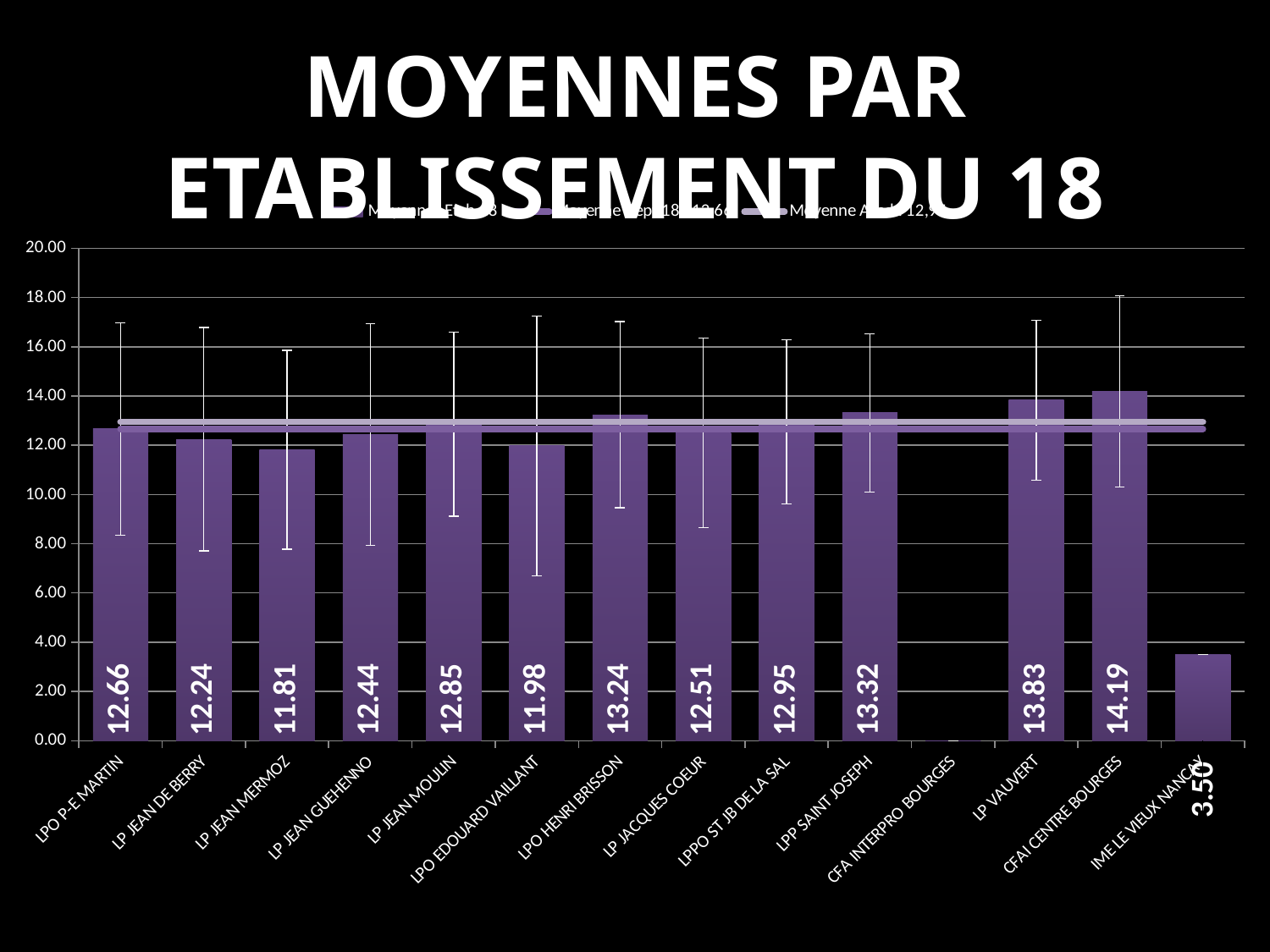
What is the difference between the values for CFAI CENTRE BOURGES and IME LE VIEUX NANCAY? 10.69 Is the value for IME LE VIEUX NANCAY greater or less than 4.00? less Which establishment has the highest value? CFAI CENTRE BOURGES What is the value for LPP SAINT JOSEPH? 13.32 What kind of chart is shown on the slide? bar chart What is the difference between the values for LP VAUVERT and LPO P-E MARTIN? 1.17 Which establishment has the lowest value shown? IME LE VIEUX NANCAY What is the value for LPO P-E MARTIN? 12.66 How many establishments are listed on the x axis? 14 Which is larger, the value for LPO HENRI BRISSON or the value for LP JACQUES COEUR? LPO HENRI BRISSON What is the value for LP JEAN MERMOZ? 11.81 What is the value for IME LE VIEUX NANCAY? 3.50